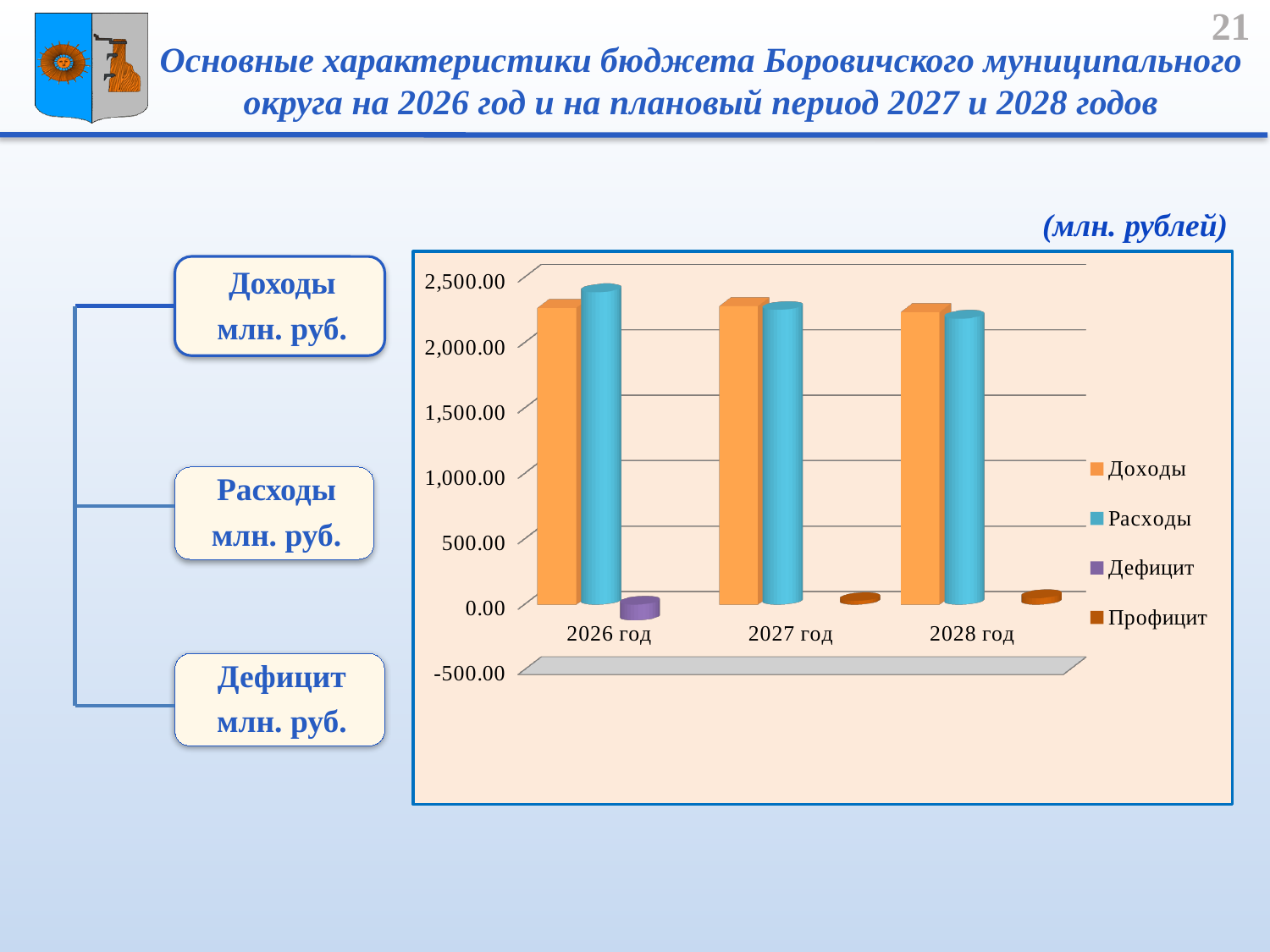
Which series is shown in purple in the chart legend? Дефицит Do the values for Расходы rise or fall from 2026 год to 2028 год? fall Is the value for Расходы in 2026 год greater or less than 2,500.00? less Is the value for Расходы in 2028 год greater or less than 2,000.00? greater Is the value for Профицит in 2027 год greater or less than 500.00? less How many year categories are shown on the x axis of the chart? 3 In 2026 год, which is larger: Доходы or Расходы? Расходы How many series does the chart legend list? 4 What unit is stated above the chart? млн. рублей What kind of chart is shown on the slide? bar chart